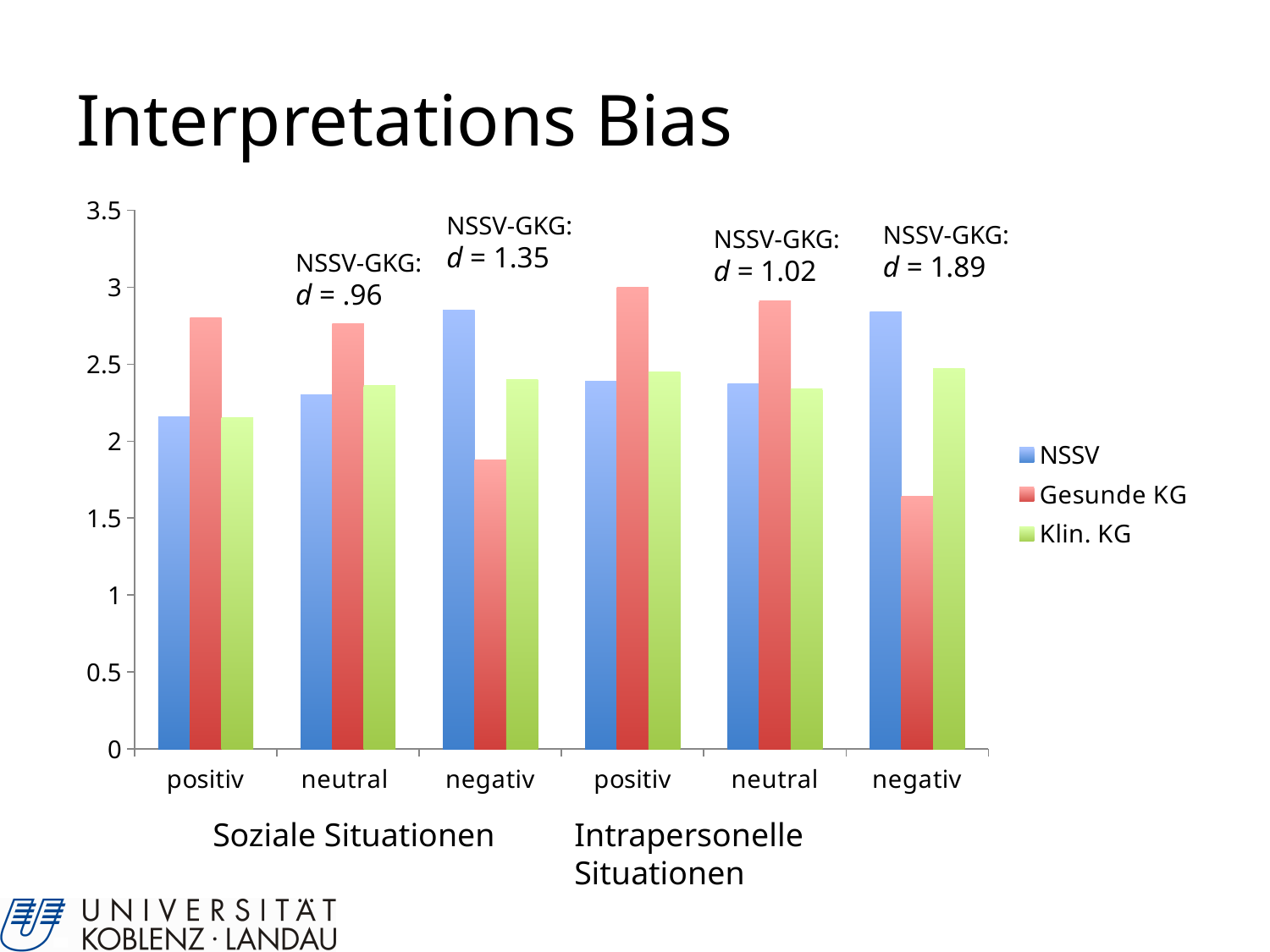
Is the Gesunde KG value for neutral in Intrapersonelle Situationen greater or less than 2.5? greater What effect size d is annotated for negativ in Intrapersonelle Situationen? 1.89 How many categories are shown along the x axis? 6 Is the Gesunde KG value for negativ in Soziale Situationen greater or less than 2? less What kind of chart is shown on the slide? bar chart For negativ in Soziale Situationen, which is larger: NSSV or Gesunde KG? NSSV Is the NSSV value for negativ in Soziale Situationen greater or less than 2.5? greater Which series is shown in green in the legend? Klin. KG For positiv in Soziale Situationen, which is larger: NSSV or Gesunde KG? Gesunde KG In which category is the Gesunde KG bar lowest? negativ (Intrapersonelle Situationen) How many series does the legend list? 3